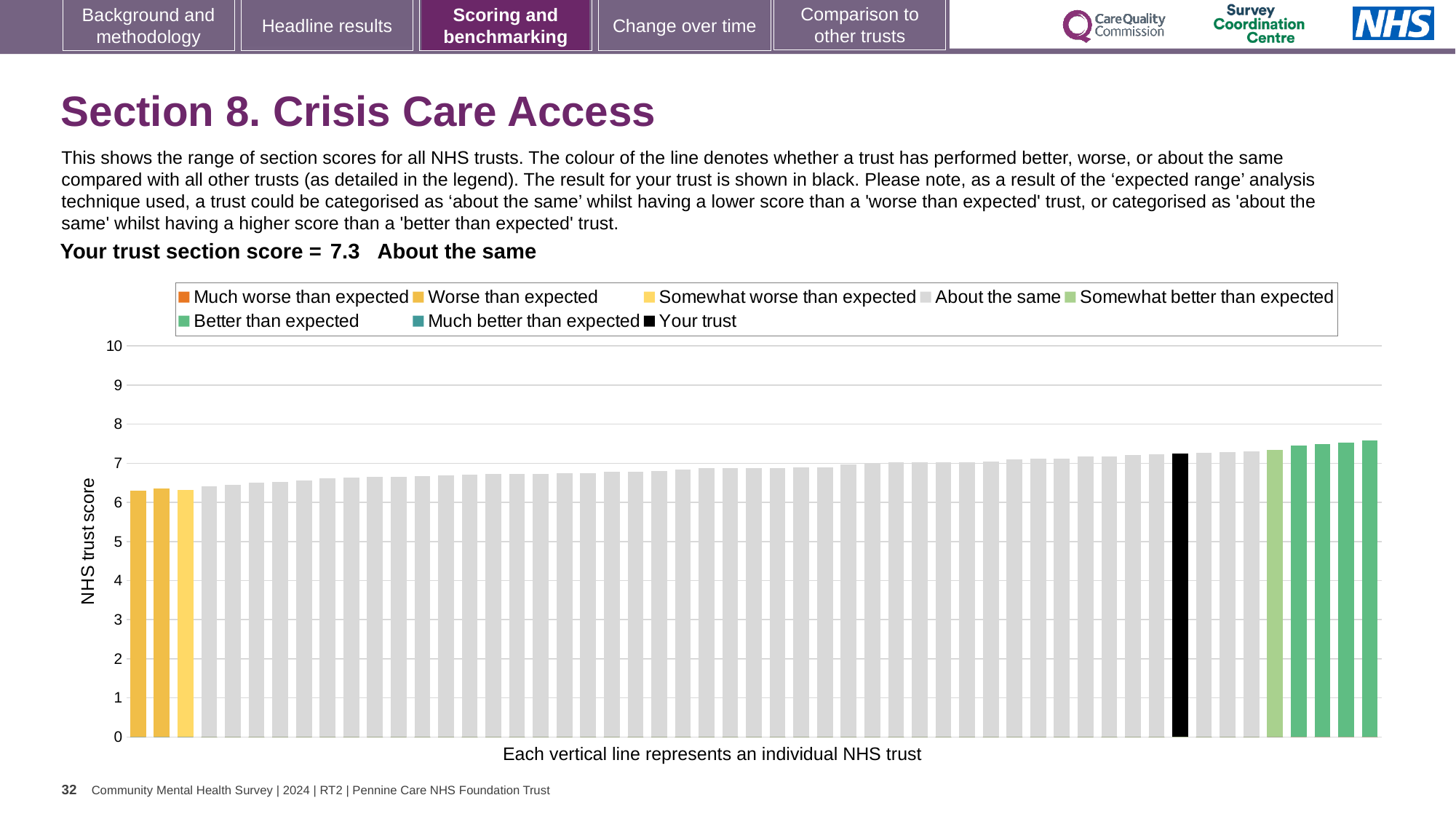
Is the value of the highest bar greater or less than 8? less Do the bar values rise or fall from left to right along the x axis? rise How many bars are coloured as 'Better than expected' (green)? 4 What is the label on the vertical axis of the chart? NHS trust score Is the value of the leftmost bar greater or less than 7? less Is the value for your trust (the black bar) greater or less than 7? greater Which is larger: the value for your trust (black bar) or the value of the leftmost bar? your trust (black bar) What kind of chart is shown on the slide? bar chart How many entries does the chart legend list? 8 What is the section score for your trust? 7.3 How many bars are coloured as 'Worse than expected' (dark yellow)? 2 How many bars are coloured as 'Much worse than expected' (orange)? 0